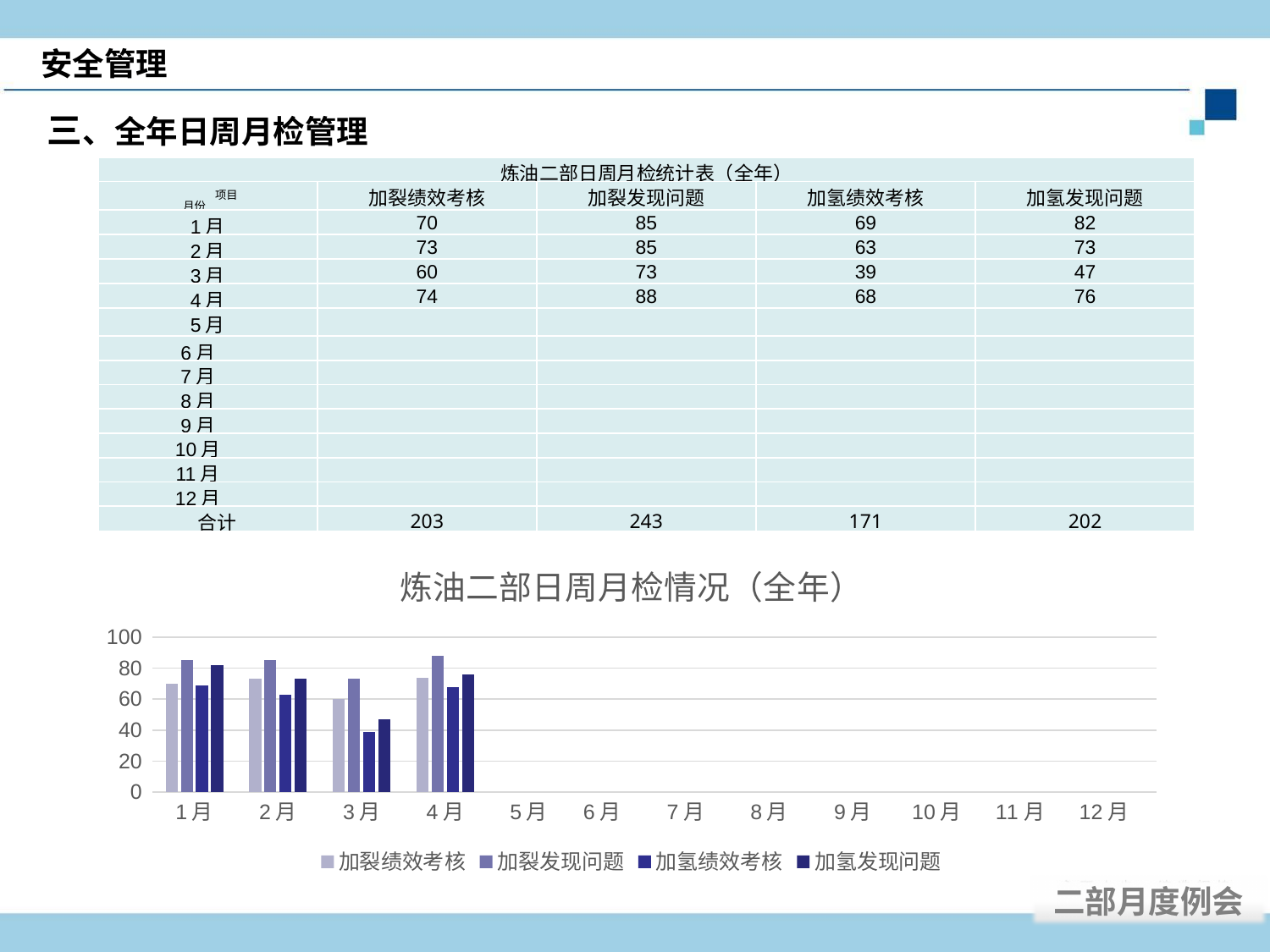
What is the value of 加裂发现问题 for 4月? 88 In which month is the 加氢绩效考核 bar lowest? 3月 In 3月, which is larger: 加裂发现问题 or 加氢发现问题? 加裂发现问题 What kind of chart is shown on the slide? bar chart How many series does the chart legend list? 4 What is the difference between 加裂绩效考核 in 4月 and in 3月? 14 What is the chart's title? 炼油二部日周月检情况（全年） For how many months does the chart show plotted bars? 4 Is the value of 加氢绩效考核 for 3月 greater or less than 60? less How many month categories are shown on the x axis of the chart? 12 Is the value of 加裂发现问题 for 1月 greater or less than 80? greater What is the value of 加氢发现问题 for 2月? 73